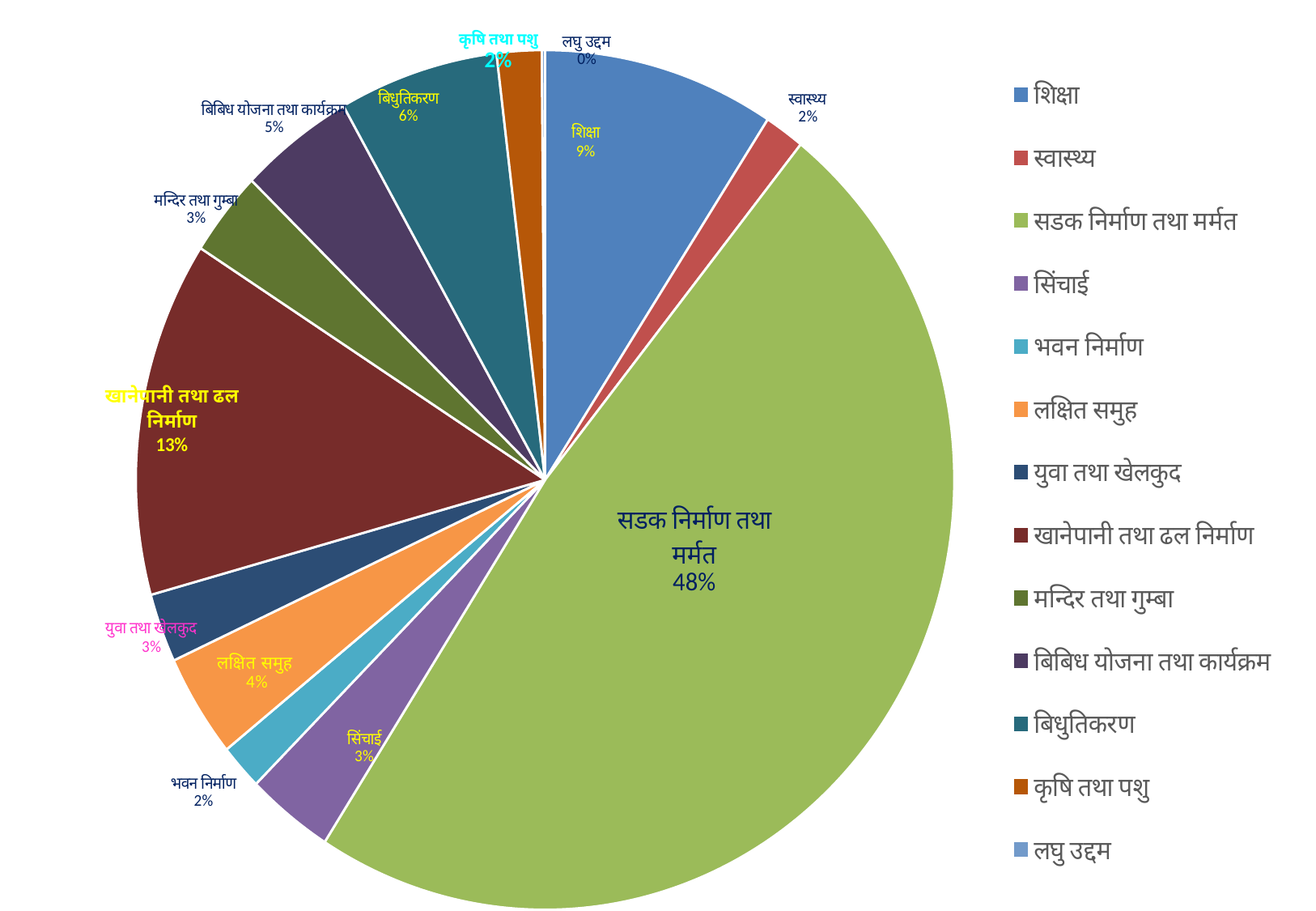
What percentage is shown for बिधुतिकरण? 6% What colour is the slice for सडक निर्माण तथा मर्मत? Green What percentage is shown for सडक निर्माण तथा मर्मत? 48% What kind of chart is shown on the slide? Pie chart What percentage is shown for शिक्षा? 9% Which category has the smallest slice of the pie? लघु उद्दम What share of the pie does लक्षित समुह represent? 4% Which category has the largest slice of the pie? सडक निर्माण तथा मर्मत What is the difference in percentage points between सडक निर्माण तथा मर्मत and खानेपानी तथा ढल निर्माण? 35 percentage points Which is larger, the slice for खानेपानी तथा ढल निर्माण or the slice for शिक्षा? खानेपानी तथा ढल निर्माण How many categories does the legend list? 13 What percentage is shown for खानेपानी तथा ढल निर्माण? 13%